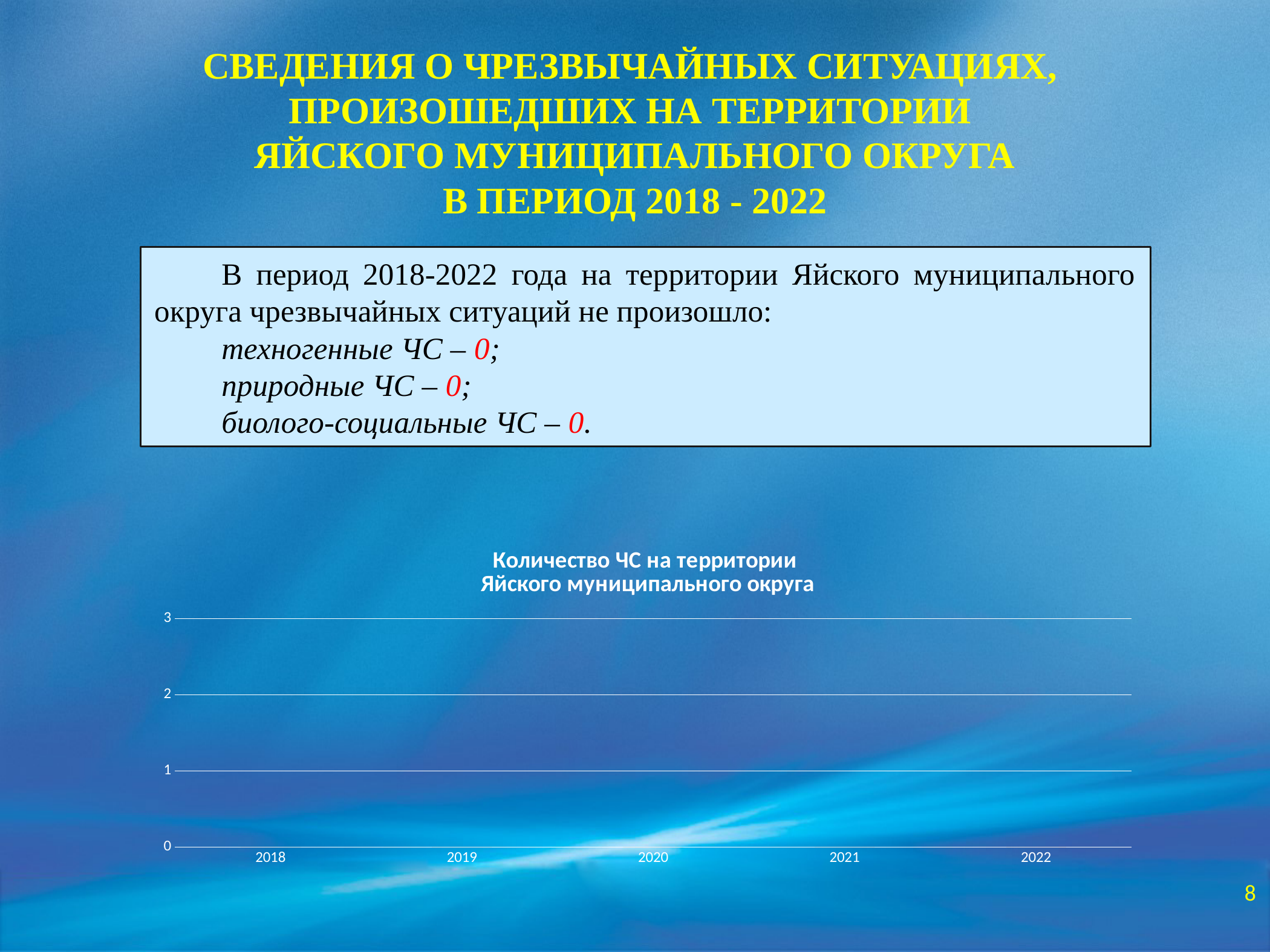
Is the value for 2020 in the chart greater or less than 1? less Which year on the x axis of the chart comes between 2019 and 2021? 2020 What is the last year shown on the x axis of the chart? 2022 What is the highest value marked on the y axis of the chart? 3 Is the value for 2018 in the chart greater or less than 1? less What is the first year shown on the x axis of the chart? 2018 What is the title of the chart at the bottom of the slide? Количество ЧС на территории Яйского муниципального округа Is the value for 2022 in the chart greater or less than 2? less Do the values in the chart rise, fall, or stay the same from 2018 to 2022? stay the same How many years are shown on the x axis of the chart? 5